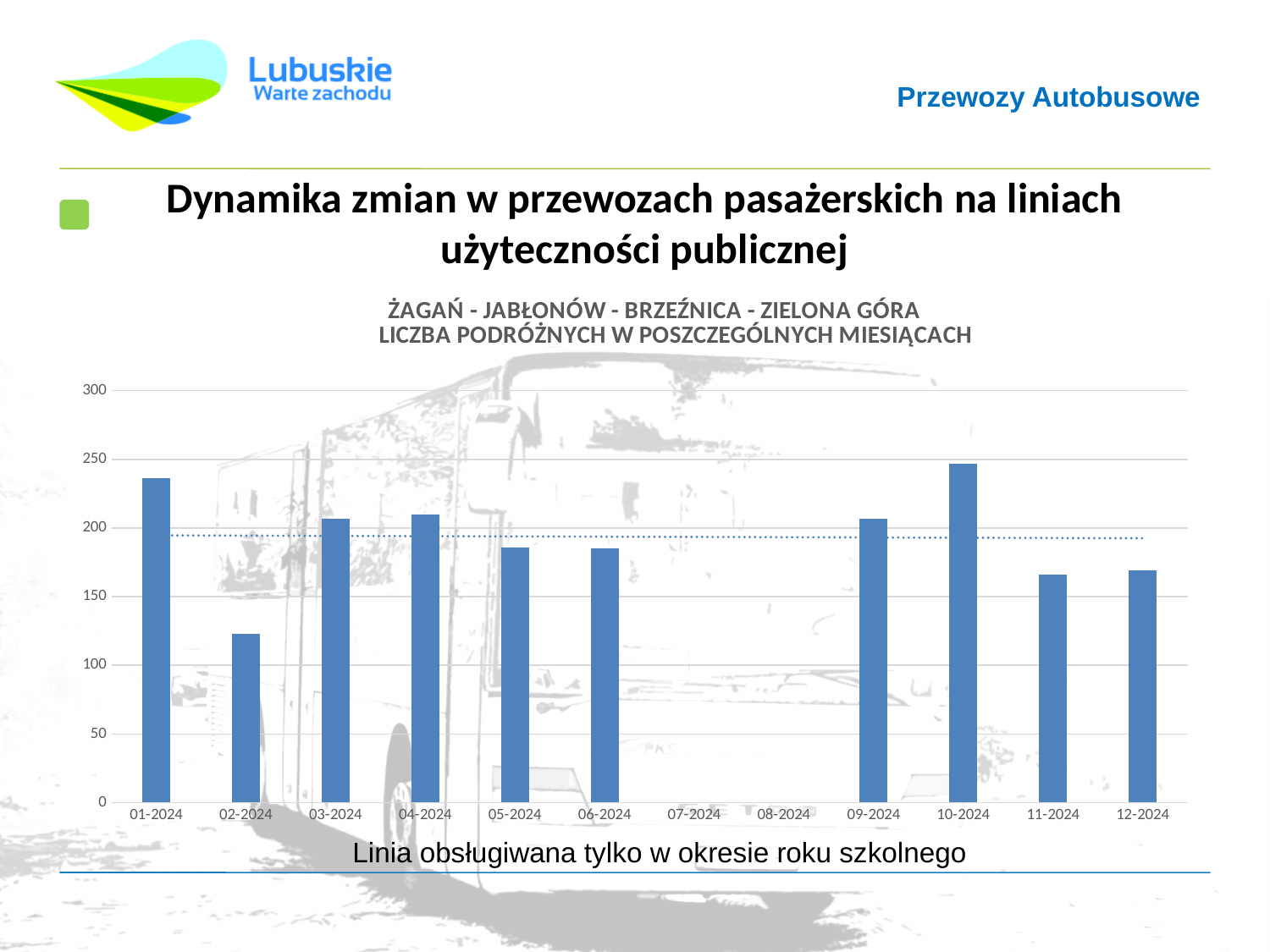
Which month has the highest number of passengers? 10-2024 Among the months with a bar shown, which has the lowest number of passengers? 02-2024 Is the value for 05-2024 greater or less than 200? less Do the values rise or fall from 10-2024 to 11-2024? fall Is the value for 11-2024 greater or less than 150? greater Which is larger, the value for 01-2024 or 02-2024? 01-2024 Which months have no bar shown on the chart? 07-2024 and 08-2024 What kind of chart is shown on the slide? bar chart Which is larger, the value for 10-2024 or 11-2024? 10-2024 Is the value for 02-2024 greater or less than 150? less How many months are listed on the x axis? 12